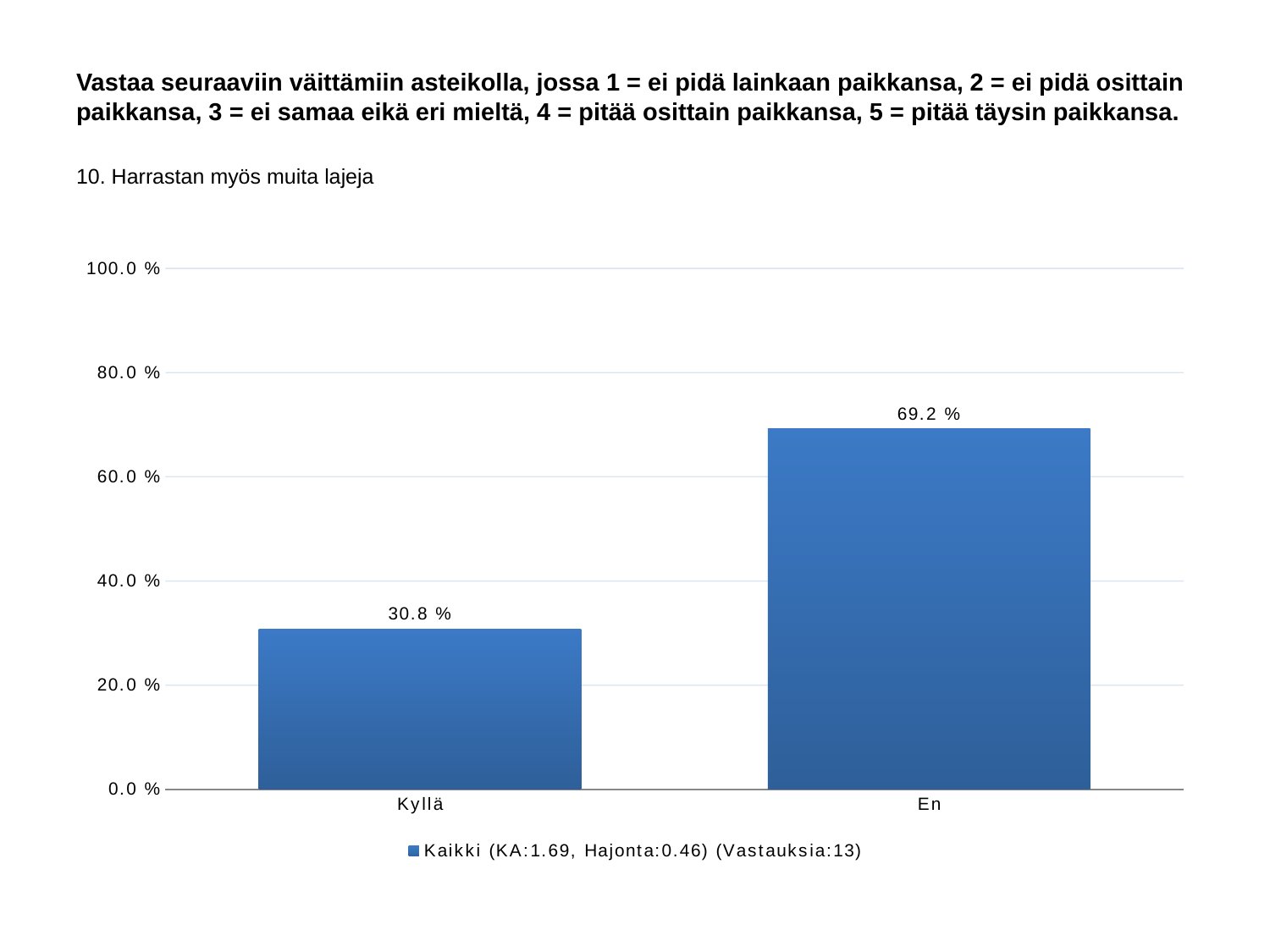
Which is larger, the value for Kyllä or the value for En? En What is the difference between the values for En and Kyllä? 38.4 % Is the value for Kyllä greater or less than 40.0 %? less What is the value for En? 69.2 % Which category has the lowest value? Kyllä What is the value for Kyllä? 30.8 % What kind of chart is shown? bar chart Is the value for En greater or less than 60.0 %? greater How many categories are shown on the x axis? 2 How many responses (Vastauksia) does the legend entry report? 13 Which category has the highest value? En How many series does the legend list? 1